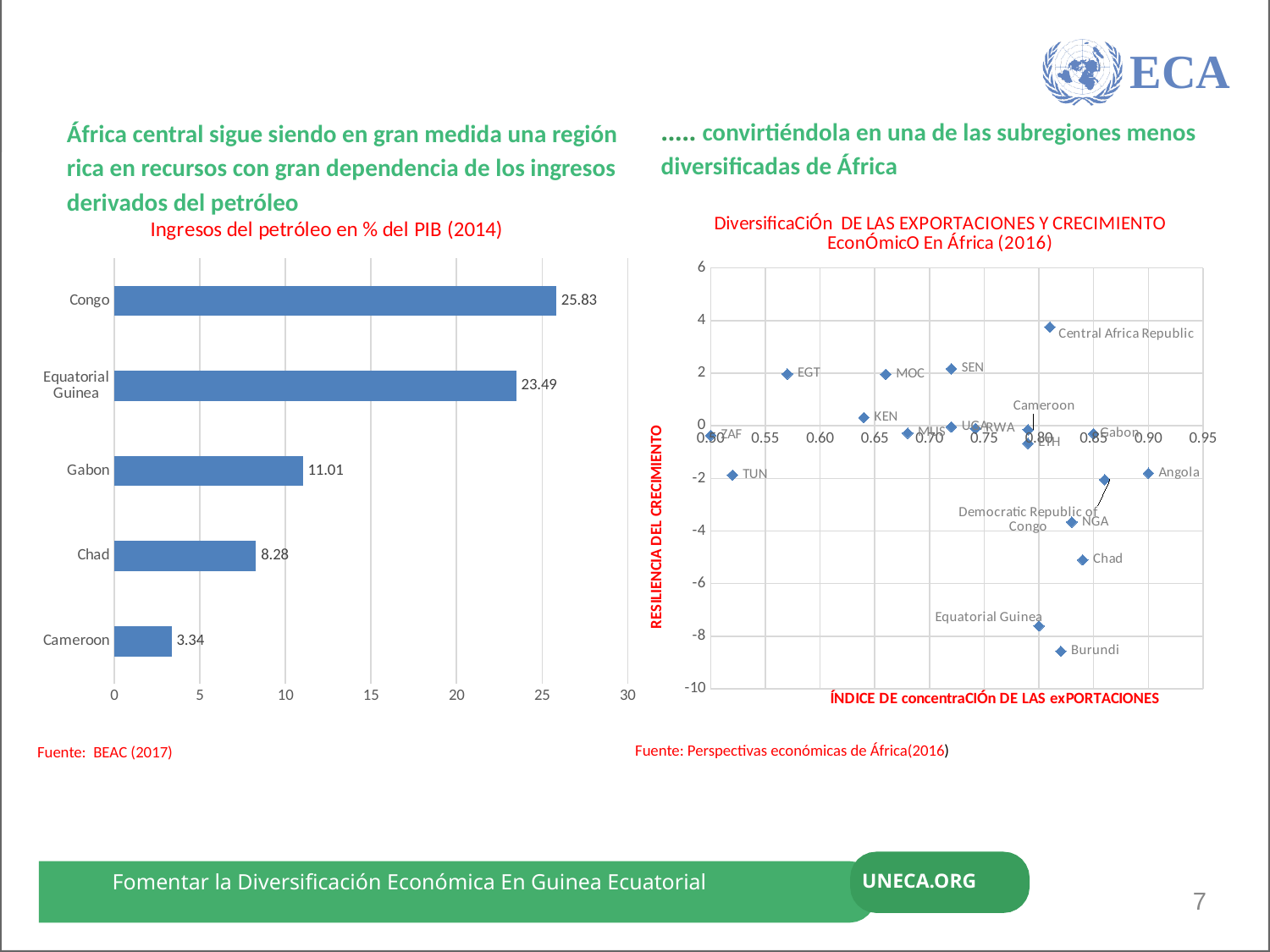
How many countries are shown in the chart 'Ingresos del petróleo en % del PIB (2014)'? 5 In the chart 'Ingresos del petróleo en % del PIB (2014)', what is the value for Chad? 8.28 In the chart 'Ingresos del petróleo en % del PIB (2014)', which country has the lowest value? Cameroon In the chart 'Ingresos del petróleo en % del PIB (2014)', which country has the highest value? Congo What kind of chart is 'Ingresos del petróleo en % del PIB (2014)'? Bar chart In the chart 'Ingresos del petróleo en % del PIB (2014)', what is the value for Congo? 25.83 In the scatter chart on the right, what is the label of the horizontal axis? ÍNDICE DE concentraCIÓn DE LAS exPORTACIONES In the chart 'Ingresos del petróleo en % del PIB (2014)', what is the difference between the values for Congo and Equatorial Guinea? 2.34 In the chart 'Ingresos del petróleo en % del PIB (2014)', which is larger, the value for Gabon or the value for Chad? Gabon In the scatter chart on the right, is the value on the vertical axis for Burundi greater or less than -8? less What kind of chart is the one on the right, 'Diversificación de las exportaciones y crecimiento económico en África (2016)'? Scatter chart In the chart 'Ingresos del petróleo en % del PIB (2014)', what is the value for Cameroon? 3.34